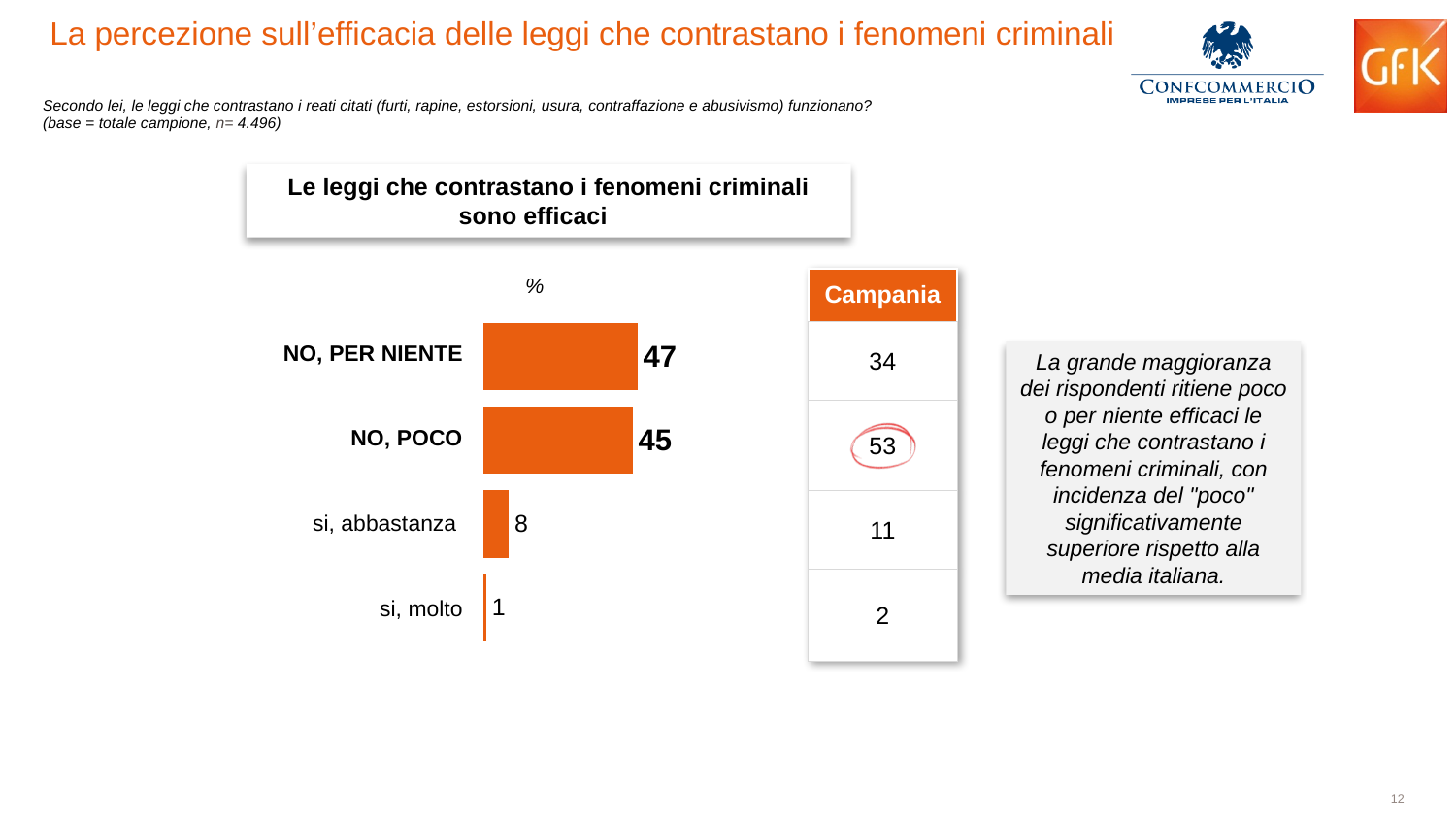
What is the value for "si, molto" in the bar chart? 1 What is the difference between the values for "si, abbastanza" and "si, molto"? 7 What is the Campania value shown next to the "NO, POCO" bar? 53 What is the difference between the values for "NO, PER NIENTE" and "NO, POCO"? 2 What is the value for "NO, POCO" in the bar chart? 45 Which category has the lowest value in the bar chart? si, molto Which is larger in the bar chart: "NO, POCO" or "si, abbastanza"? NO, POCO What is the value for "NO, PER NIENTE" in the bar chart? 47 How many categories are shown in the bar chart? 4 What type of chart is shown on the slide? Bar chart What is the value for "si, abbastanza" in the bar chart? 8 Which category has the highest value in the bar chart? NO, PER NIENTE